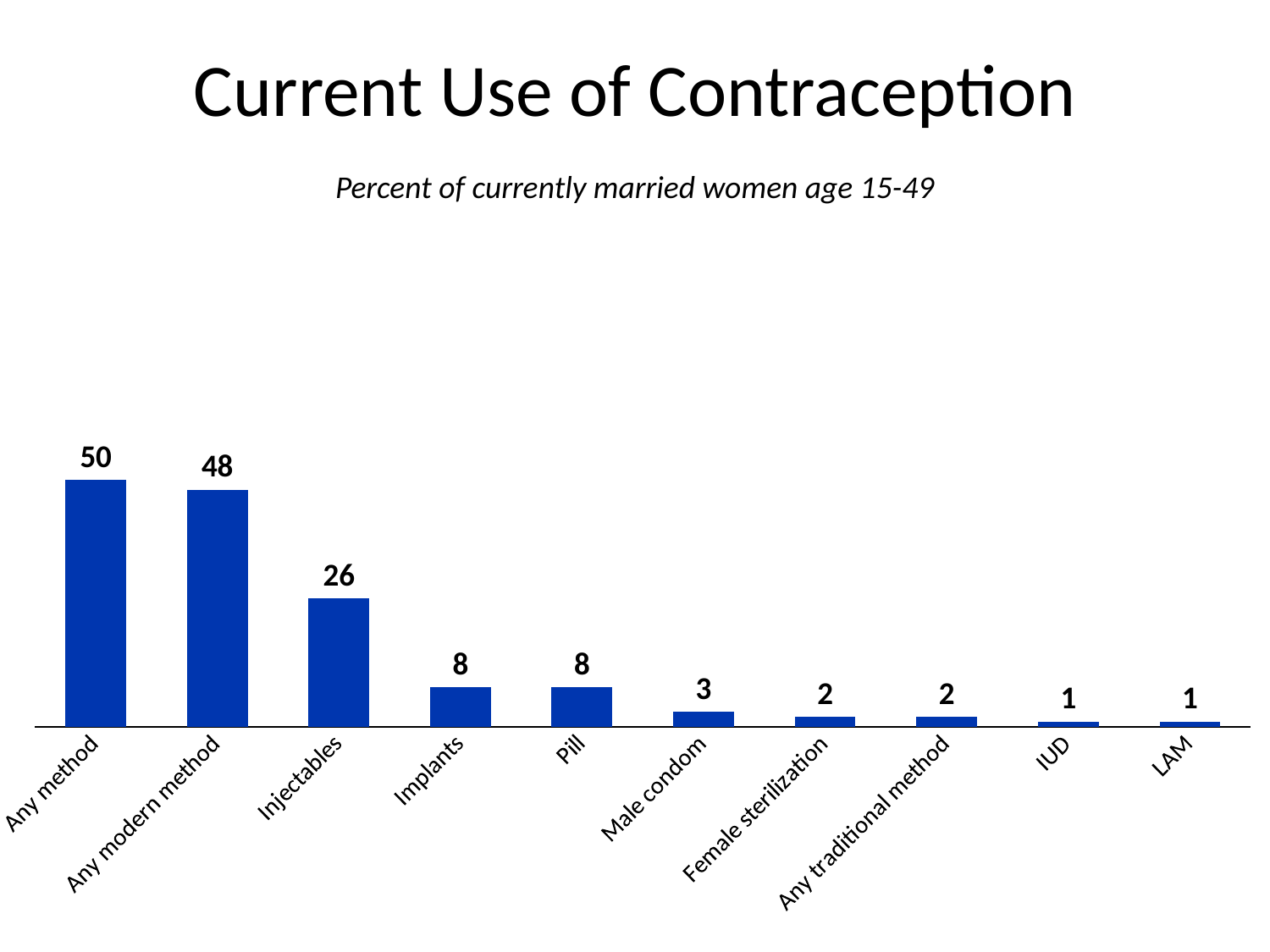
What is the difference between the values for Any method and Any modern method? 2 What is the value for Male condom? 3 Do the values rise or fall from left to right along the x axis? Fall What is the value for Any modern method? 48 Which category has the highest value? Any method What is the difference between the values for Injectables and Implants? 18 How many categories are shown on the chart? 10 What kind of chart is shown on the slide? Bar chart What is the value for Injectables? 26 What is the title of the chart? Current Use of Contraception What is the value for Any traditional method? 2 Which is larger, the value for Injectables or the value for Pill? Injectables